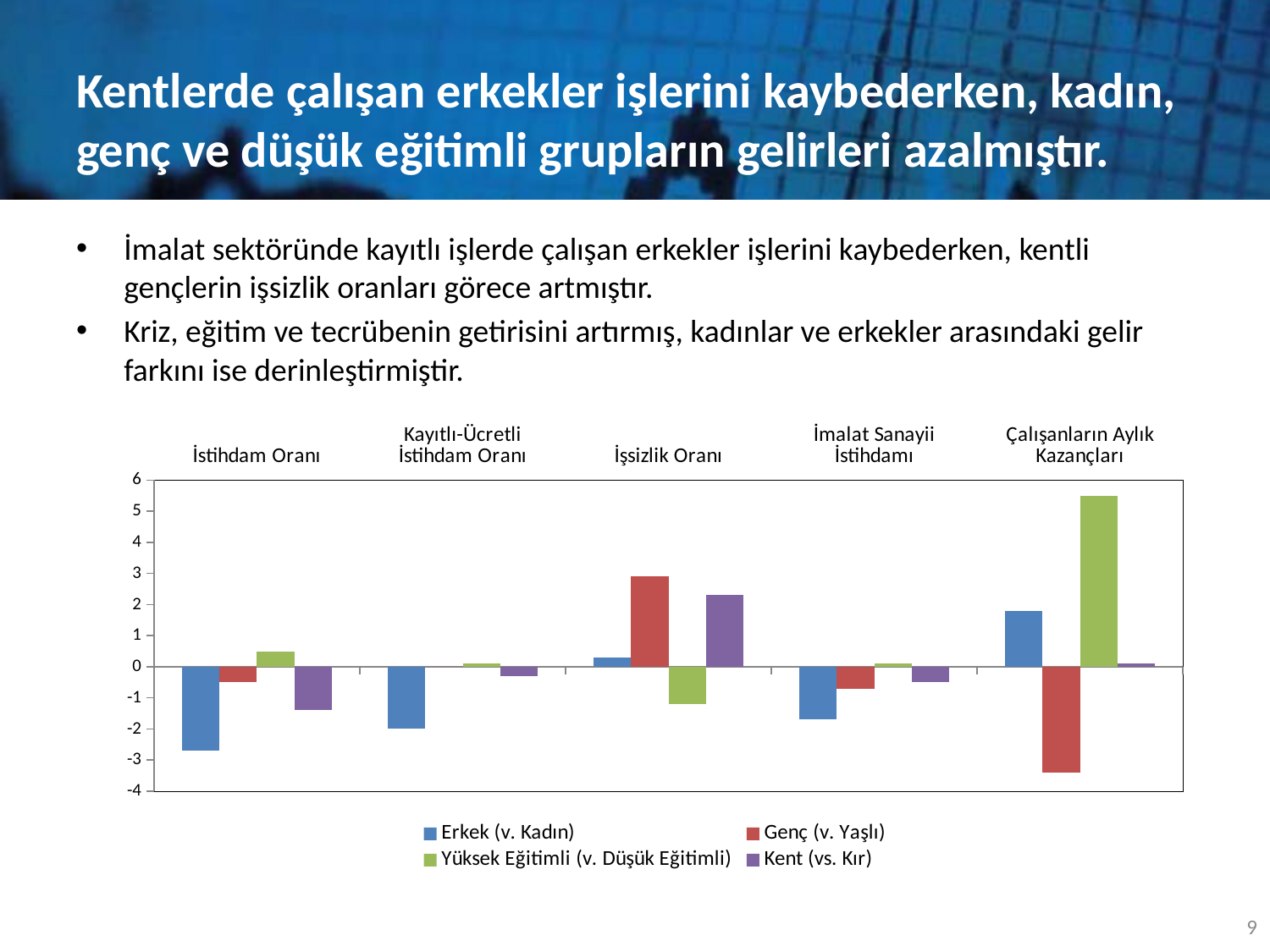
Is the value for Yüksek Eğitimli (v. Düşük Eğitimli) in Çalışanların Aylık Kazançları greater or less than 5? greater Which series has the lowest value in the Çalışanların Aylık Kazançları category? Genç (v. Yaşlı) Which series has the lowest value in the İstihdam Oranı category? Erkek (v. Kadın) What kind of chart is shown on the slide? bar chart Is the value for Genç (v. Yaşlı) in İşsizlik Oranı greater or less than 2? greater What colour are the bars for the Kent (vs. Kır) series? purple In the İşsizlik Oranı category, which is larger: the value for Genç (v. Yaşlı) or the value for Kent (vs. Kır)? Genç (v. Yaşlı) Is the value for Erkek (v. Kadın) in İstihdam Oranı greater or less than -2? less Which series has the highest value in the Çalışanların Aylık Kazançları category? Yüksek Eğitimli (v. Düşük Eğitimli) How many series does the chart's legend list? 4 How many categories are shown along the x axis of the chart? 5 In the İmalat Sanayii İstihdamı category, which is larger: the value for Erkek (v. Kadın) or the value for Genç (v. Yaşlı)? Genç (v. Yaşlı)